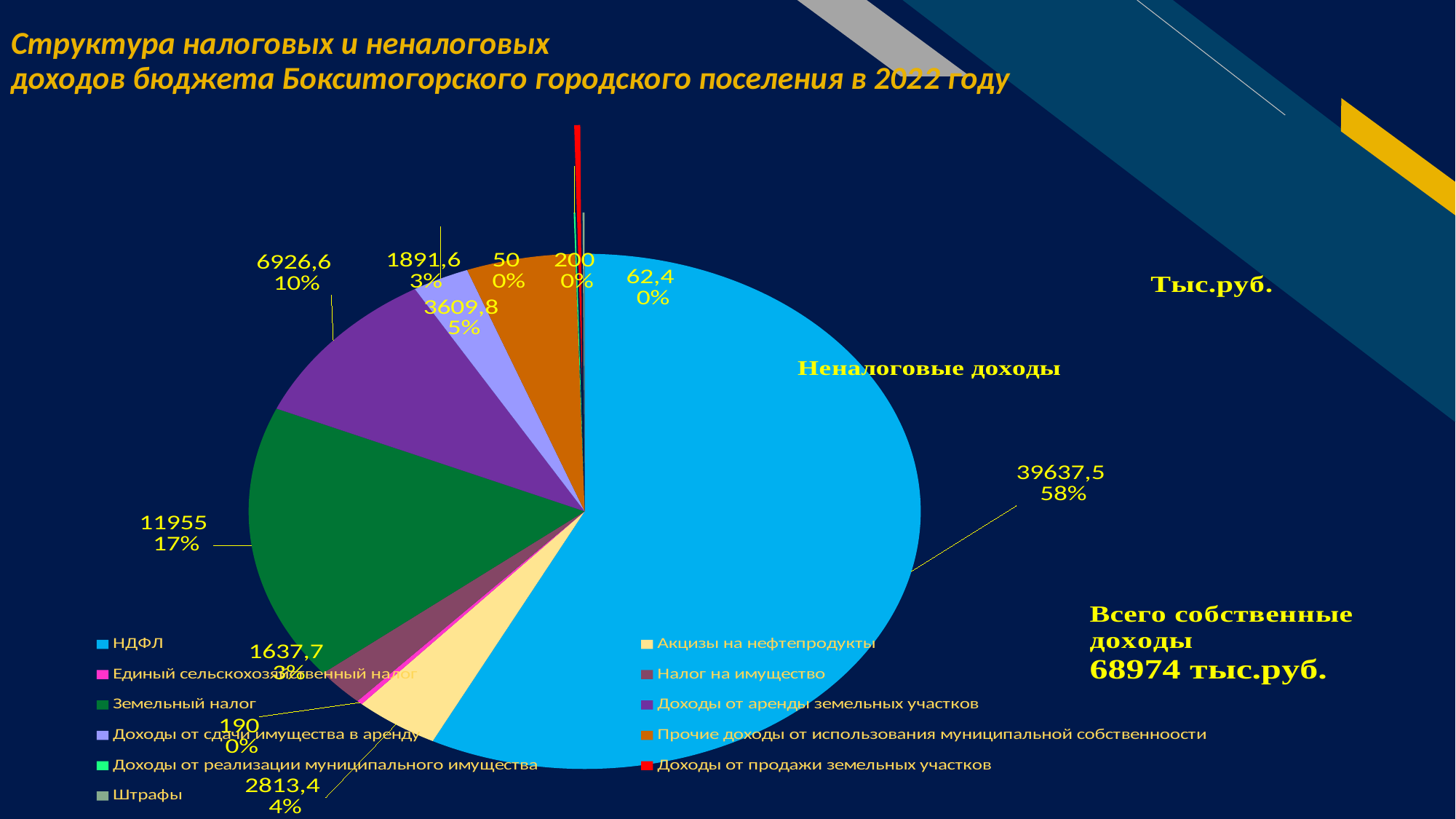
Which is larger, Земельный налог or Акцизы на нефтепродукты? Земельный налог What is the value shown for НДФЛ? 39637,5 What total own revenues amount is stated on the slide? 68974 тыс.руб. What is the difference between the values for Земельный налог and Доходы от аренды земельных участков? 5028,4 How many categories does the legend list? 11 What is the value shown for Акцизы на нефтепродукты? 2813,4 What type of chart is shown on the slide? pie chart What is the smallest data value printed on the chart? 50 What share of the pie does Земельный налог represent? 17% What share of the pie does НДФЛ represent? 58% What is the value shown for Земельный налог? 11955 Which category has the largest slice of the pie? НДФЛ